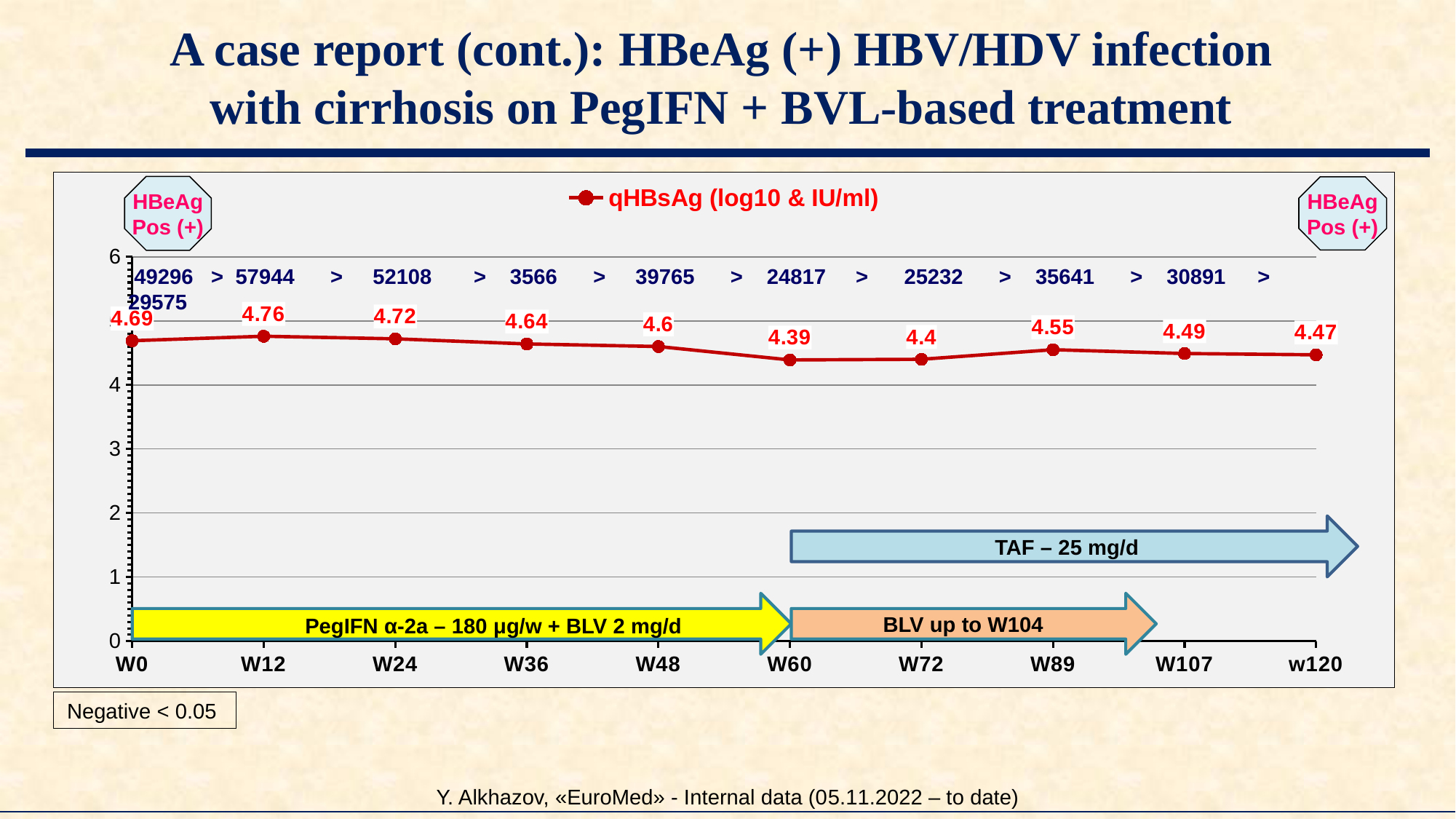
What is the qHBsAg value at W12? 4.76 What kind of chart is shown on the slide? line chart At which time point is the qHBsAg value lowest? W60 What is the qHBsAg value at w120? 4.47 How many series does the legend list? 1 How many time points are plotted on the x axis? 10 What series name is shown in the chart legend? qHBsAg (log10 & IU/ml) What is the qHBsAg value at W60? 4.39 Is the qHBsAg value at W48 greater or less than 4? greater At which time point is the qHBsAg value highest? W12 Which is larger, the qHBsAg value at W0 or at W89? W0 What is the difference between the qHBsAg values at W12 and W60? 0.37